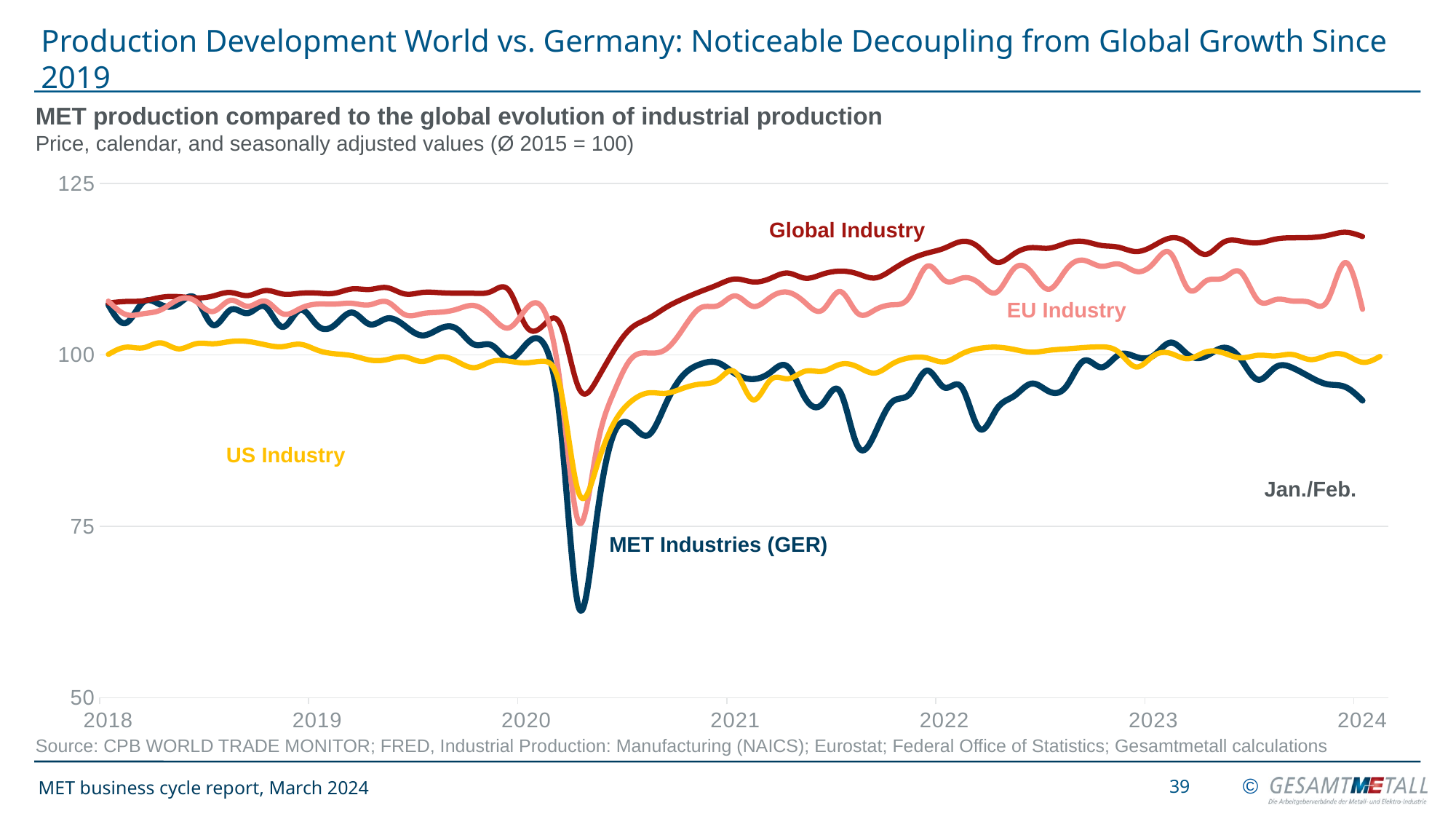
Which series reaches the lowest value during the 2020 dip? MET Industries (GER) Is the value for Global Industry at the start of 2024 greater or less than 100? greater How many series are plotted in the chart? 4 Is the value for EU Industry at its 2020 low greater or less than 100? less Is the value for MET Industries (GER) at the start of 2024 greater or less than 100? less Which series has the highest value at the end of the chart in 2024? Global Industry Does the Global Industry series rise or fall overall from 2021 to 2024? rise What kind of chart is shown on the slide? line chart Does the MET Industries (GER) series rise or fall from 2023 to 2024? fall At the start of 2024, which is higher: Global Industry or MET Industries (GER)? Global Industry What base year is set equal to 100 in the chart's index? 2015